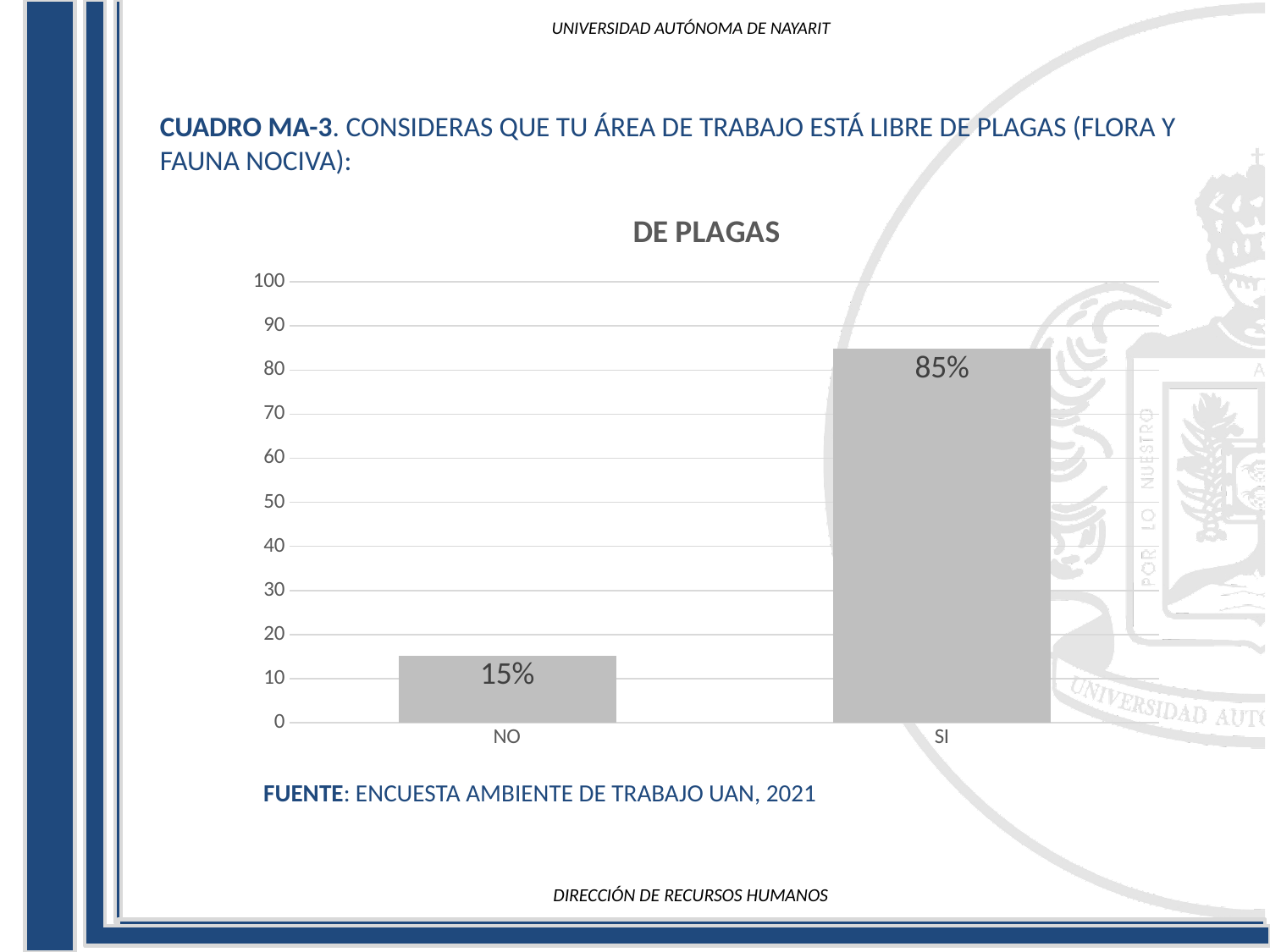
Is the value for NO greater or less than 20? less Which category has the highest value? SI Which is larger, the value for NO or the value for SI? SI What is the value for SI? 85% Which category has the lowest value? NO Is the value for SI greater or less than 80? greater What is the highest value shown on the y axis? 100 What kind of chart is shown on the slide? bar chart How many categories are shown on the x axis? 2 What is the title shown above the chart? DE PLAGAS What is the difference between the values for SI and NO? 70% What is the value for NO? 15%